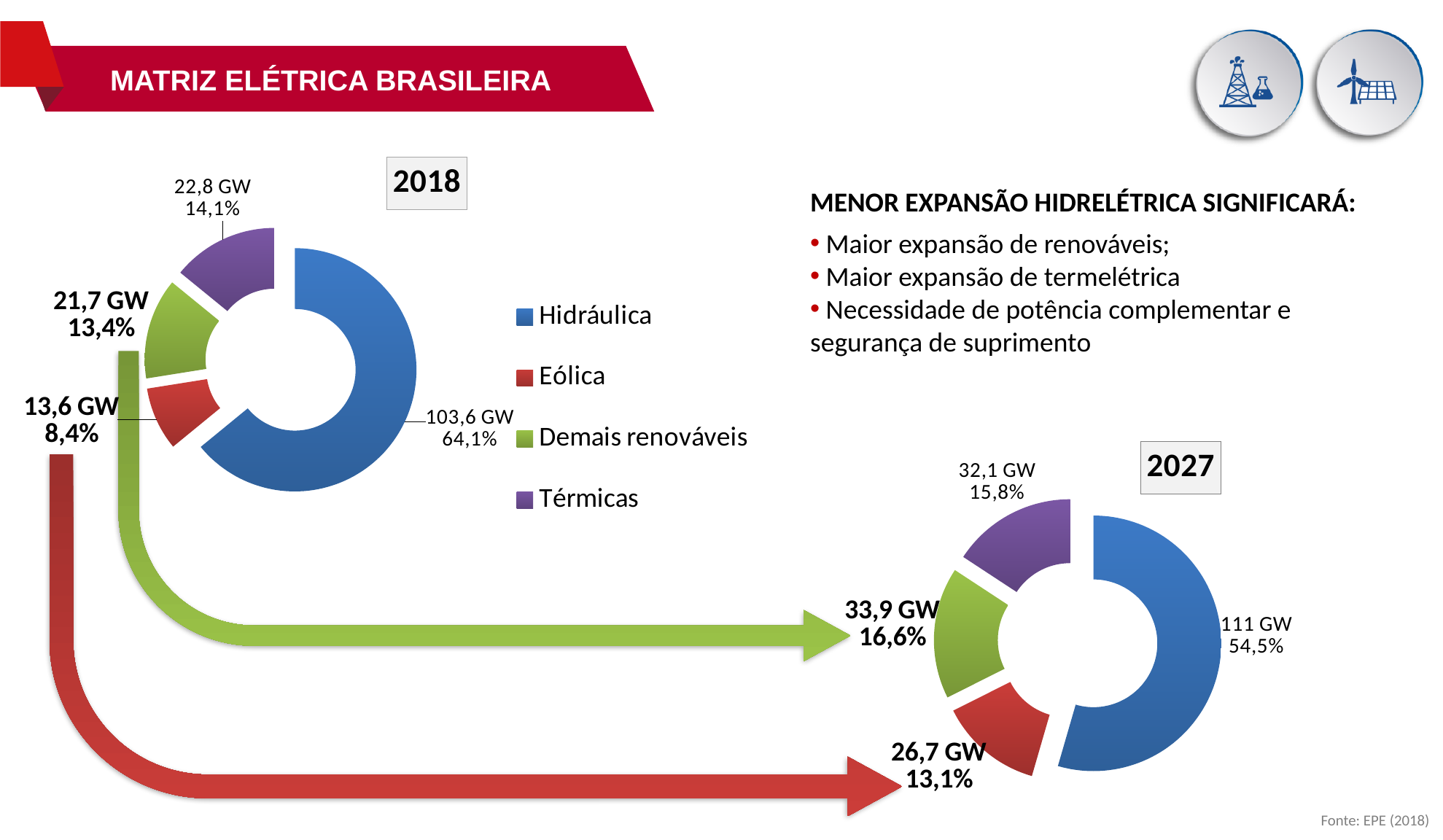
What kind of chart is the 2027 chart? Doughnut chart In the 2018 chart, what share does Eólica have? 8,4% In the 2018 chart, what is the value for Hidráulica? 103,6 GW In the 2018 chart, which is larger, Térmicas or Demais renováveis? Térmicas In the 2027 chart, what share does Térmicas have? 15,8% How many categories does the 2018 chart show? 4 Which colour represents Eólica in the legend? Red In the 2027 chart, which category has the smallest share? Eólica In the 2018 chart, which category has the largest share? Hidráulica In the 2027 chart, what is the value for Demais renováveis? 33,9 GW In the 2027 chart, what is the difference in GW between Hidráulica and Eólica? 84,3 GW How many entries does the legend list? 4